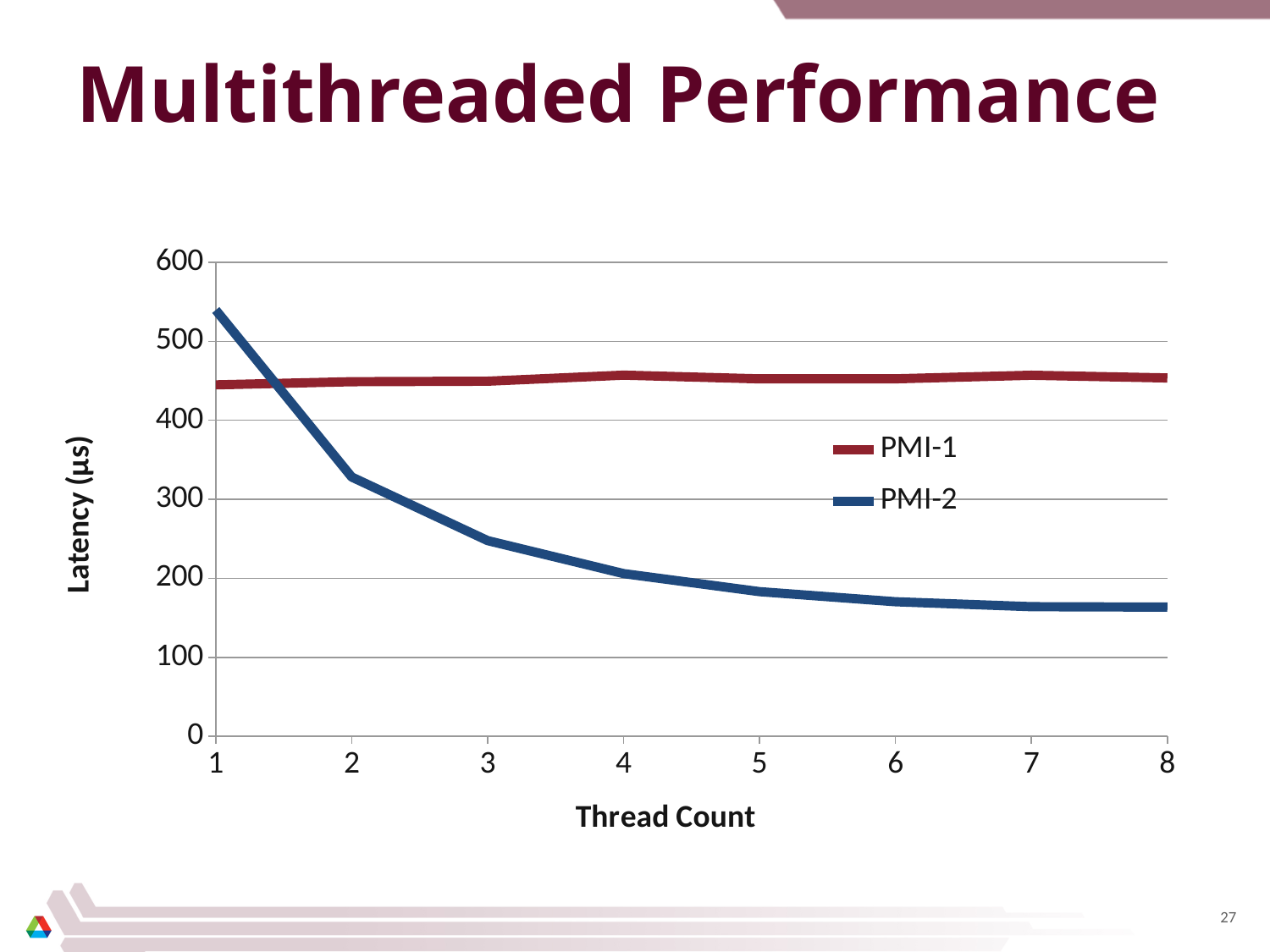
Does the PMI-2 latency rise or fall as the thread count increases from 1 to 8? fall Is the PMI-1 latency at thread count 4 greater or less than 400? greater At thread count 1, which series has the higher latency, PMI-1 or PMI-2? PMI-2 How many series does the legend list? 2 Is the PMI-2 latency at thread count 8 greater or less than 200? less What is the label of the y axis? Latency (µs) How many thread count values are plotted along the x axis? 8 Is the PMI-2 latency at thread count 3 greater or less than 300? less What is the title of the slide containing the chart? Multithreaded Performance At thread count 8, which series has the higher latency, PMI-1 or PMI-2? PMI-1 What kind of chart is shown on the slide? line chart